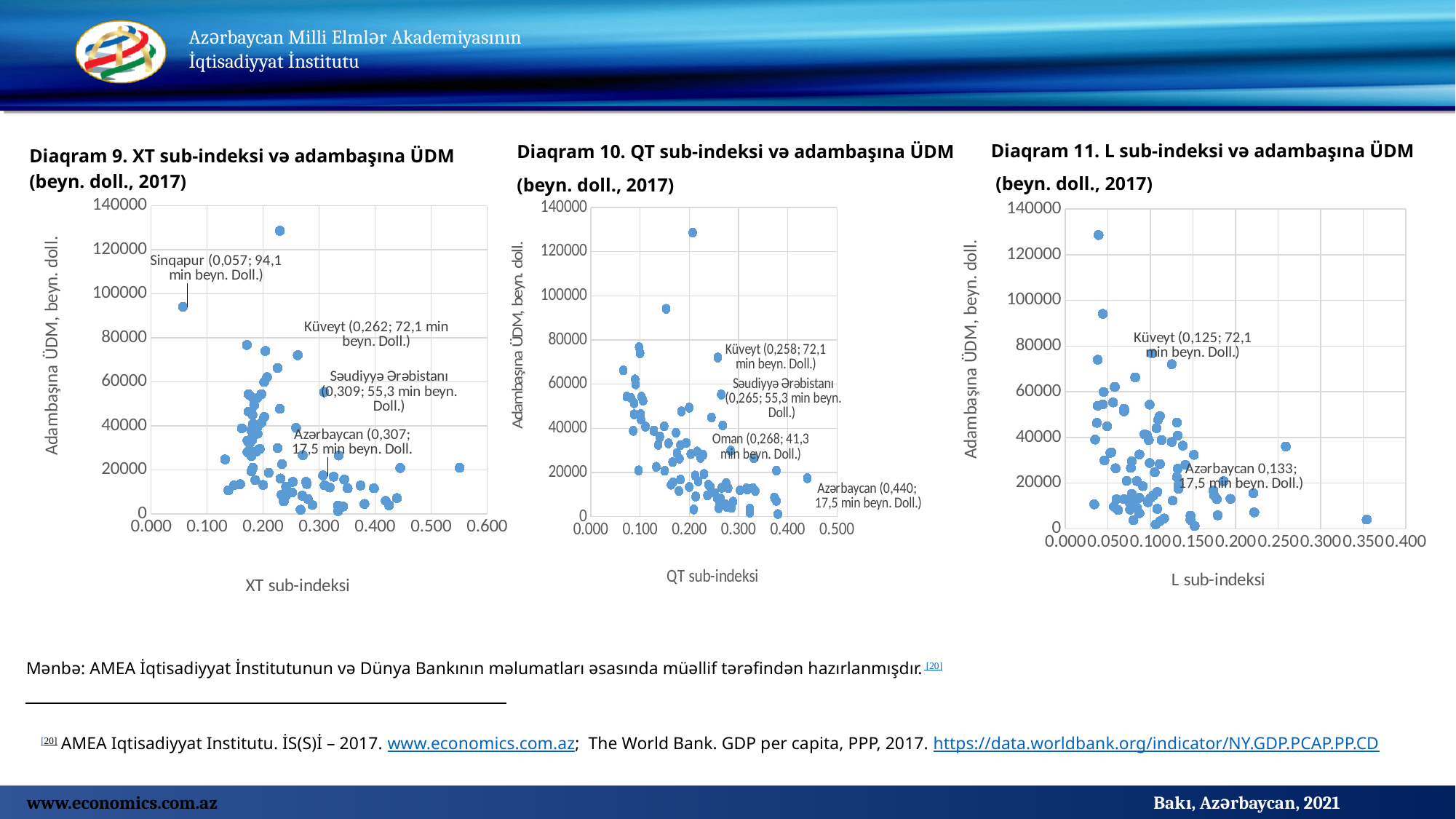
In Diaqram 10 (QT sub-indeksi), what QT sub-index value is labelled for Azərbaycan? 0,440 What kind of chart is Diaqram 9 (XT sub-indeksi və adambaşına ÜDM)? Scatter chart In Diaqram 9 (XT sub-indeksi), what GDP per capita is labelled for Küveyt? 72,1 min beyn. Doll. In Diaqram 11 (L sub-indeksi), what GDP per capita is labelled for Azərbaycan? 17,5 min beyn. Doll. In Diaqram 9 (XT sub-indeksi), what XT sub-index value is labelled for Sinqapur? 0,057 In Diaqram 10 (QT sub-indeksi), what GDP per capita is labelled for Oman? 41,3 min beyn. Doll. What is the x-axis title of Diaqram 10? QT sub-indeksi In Diaqram 11 (L sub-indeksi), what L sub-index value is labelled for Küveyt? 0,125 In Diaqram 11 (L sub-indeksi), is the highest plotted GDP per capita value greater or less than 120000? greater In Diaqram 9 (XT sub-indeksi), which has the higher labelled GDP per capita, Səudiyyə Ərəbistanı or Azərbaycan? Səudiyyə Ərəbistanı In Diaqram 10 (QT sub-indeksi), what QT sub-index value is labelled for Səudiyyə Ərəbistanı? 0,265 In Diaqram 9 (XT sub-indeksi), what XT sub-index value is labelled for Azərbaycan? 0,307